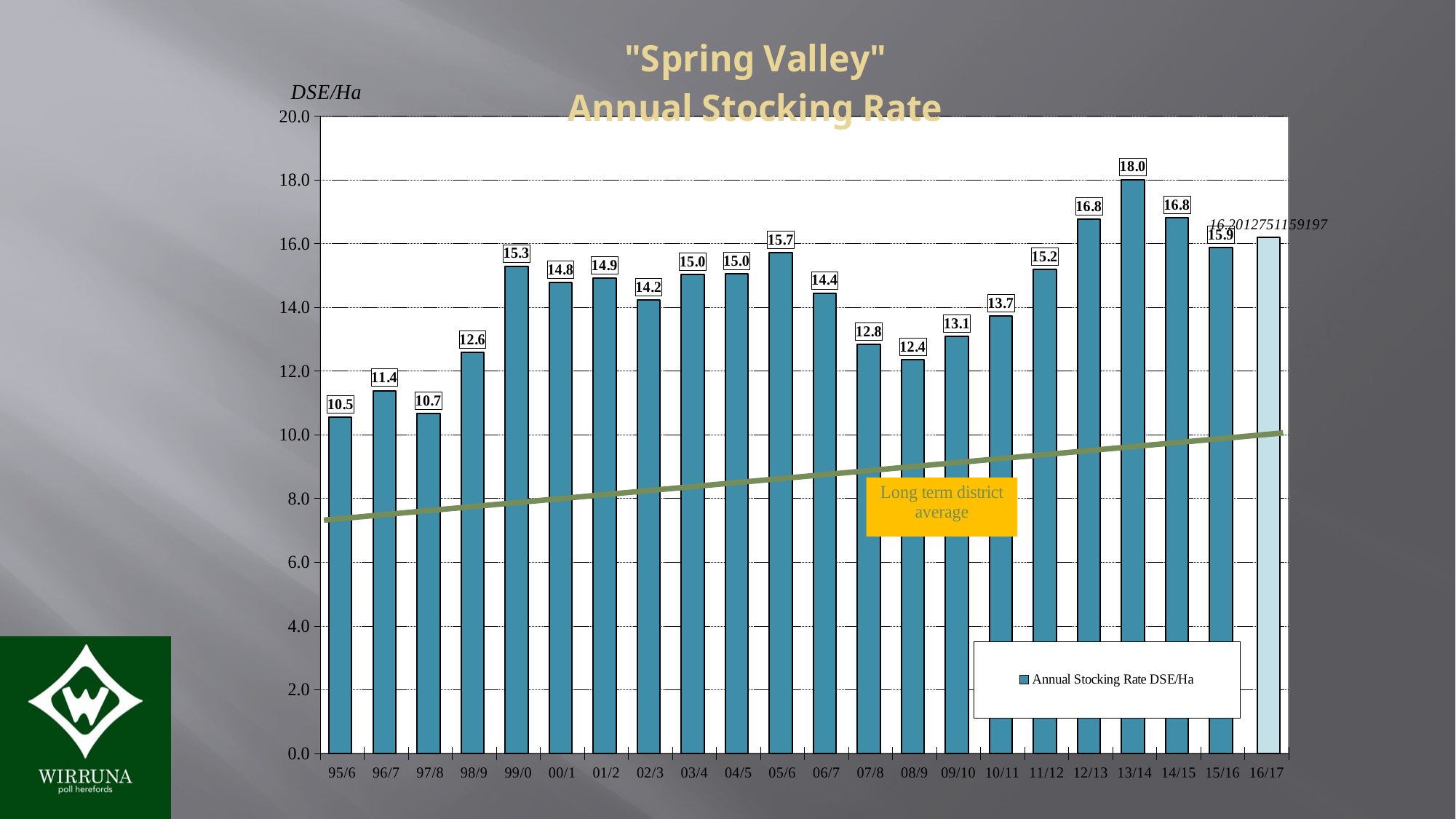
What is the difference between the stocking rate in 12/13 and in 11/12? 1.6 Which year has the lowest annual stocking rate? 95/6 What is the annual stocking rate for 95/6? 10.5 How many years are shown on the x axis? 22 What is the annual stocking rate for 13/14? 18.0 Which year has the highest annual stocking rate? 13/14 Which year has the higher stocking rate, 05/6 or 06/7? 05/6 What is the annual stocking rate for 12/13? 16.8 Is the value for 16/17 greater or less than 14.0? greater What kind of chart is shown on the slide? bar chart What is the difference between the stocking rate in 13/14 and in 95/6? 7.5 How many series does the legend list? 1